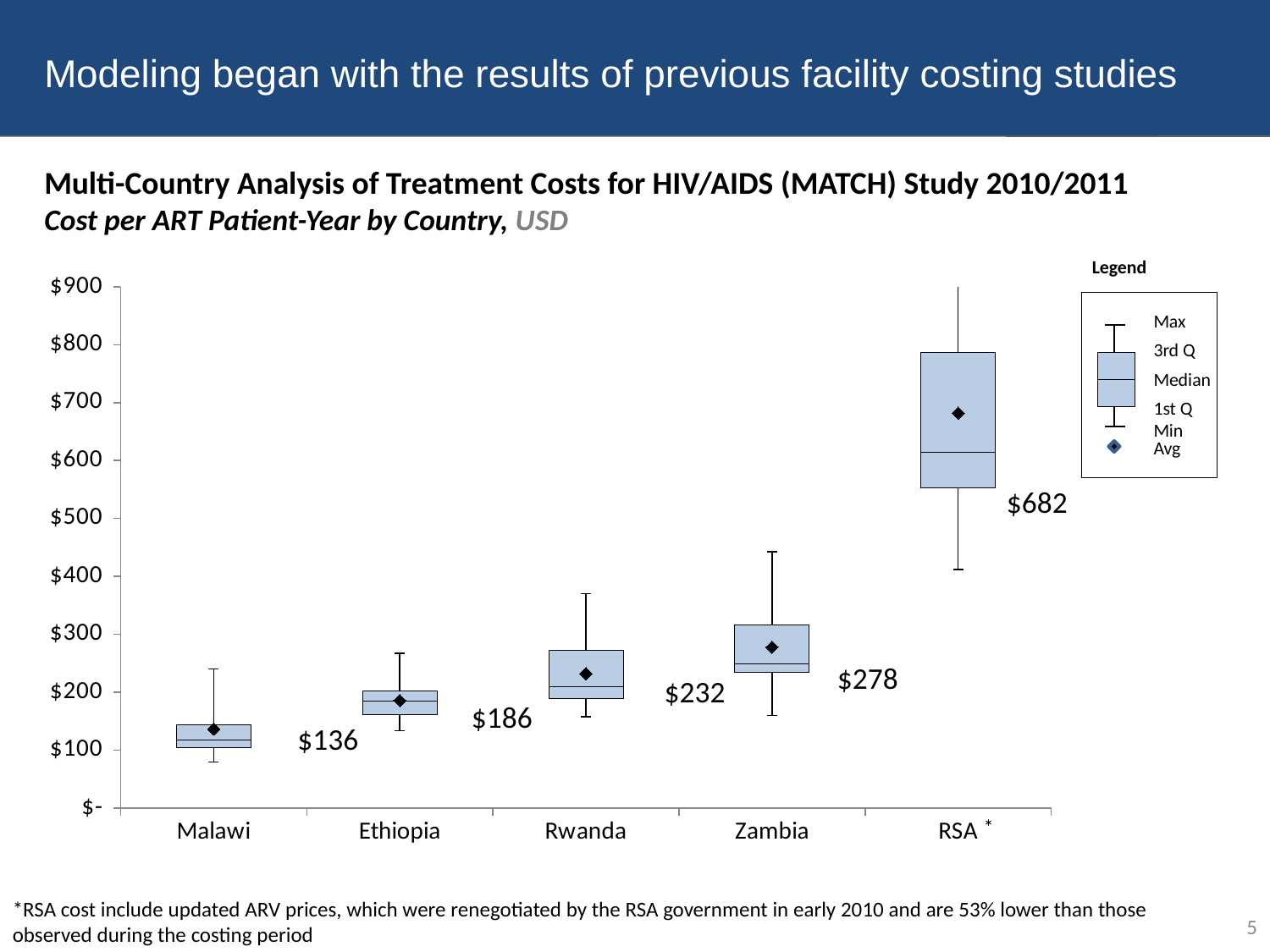
How many countries are shown on the x axis of the chart? 5 Is the maximum value for Zambia greater or less than $400? greater Which has a higher average cost per ART patient-year, Rwanda or Ethiopia? Rwanda What is the average cost per ART patient-year for Ethiopia? $186 What is the difference between the average cost per ART patient-year for RSA and Zambia? $404 What is the average cost per ART patient-year for Malawi? $136 What is the average cost per ART patient-year for Zambia? $278 What kind of chart is shown on the slide? Box plot Which country has the lowest average cost per ART patient-year? Malawi What is the average cost per ART patient-year for Rwanda? $232 Which country has the highest average cost per ART patient-year? RSA What is the average cost per ART patient-year for RSA? $682